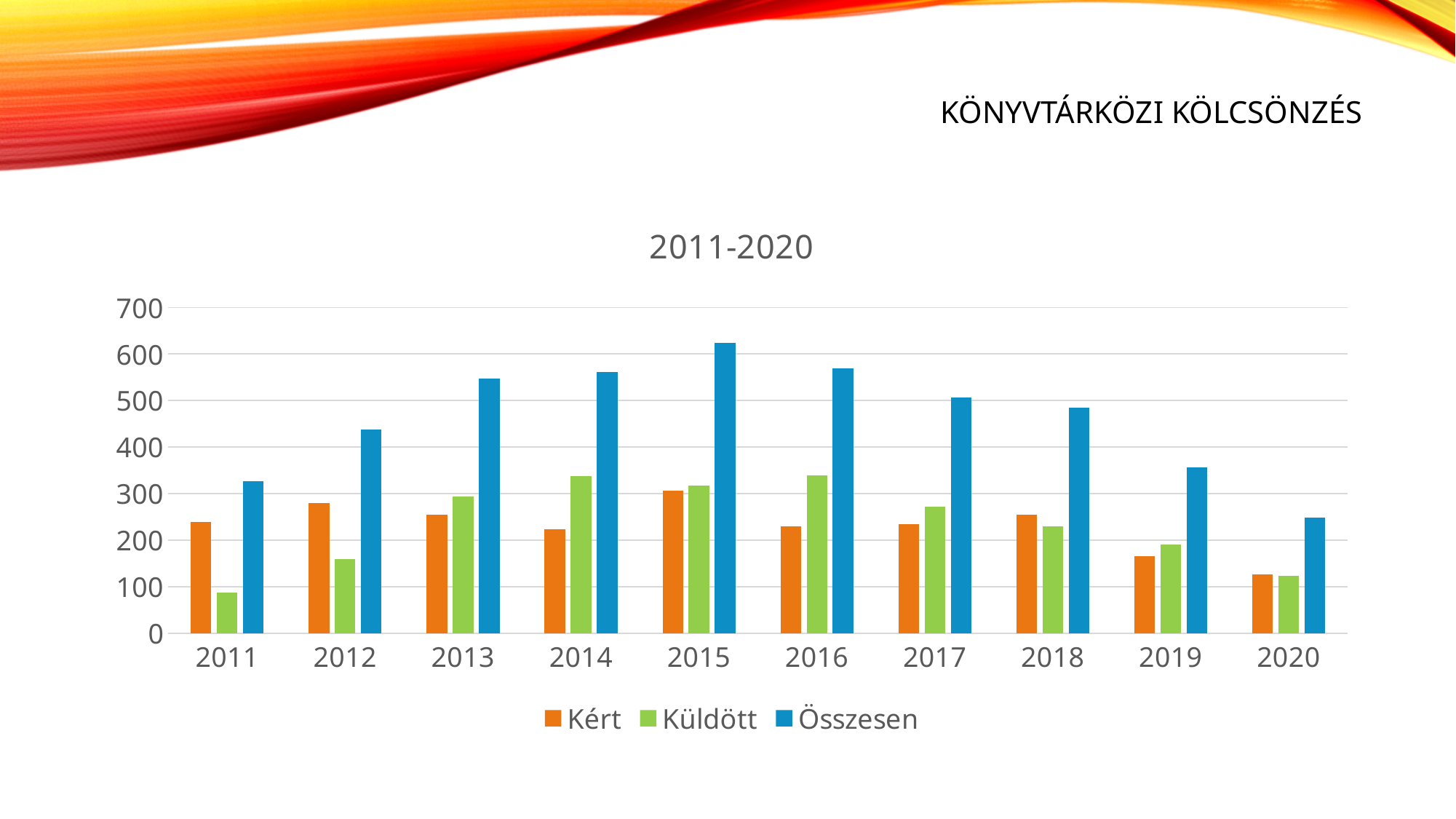
What kind of chart is shown on the slide? bar chart In which year is the Összesen value highest? 2015 In 2014, which is larger: Kért or Küldött? Küldött In 2011, which is larger: Kért or Küldött? Kért Do the Összesen values rise or fall from 2015 to 2020? fall In which year is the Összesen value lowest? 2020 How many years are shown on the x axis? 10 In which year is the Küldött value lowest? 2011 Is the Összesen value for 2020 greater or less than 300? less How many series does the legend list? 3 Is the Összesen value for 2015 greater or less than 600? greater Is the Küldött value for 2011 greater or less than 100? less